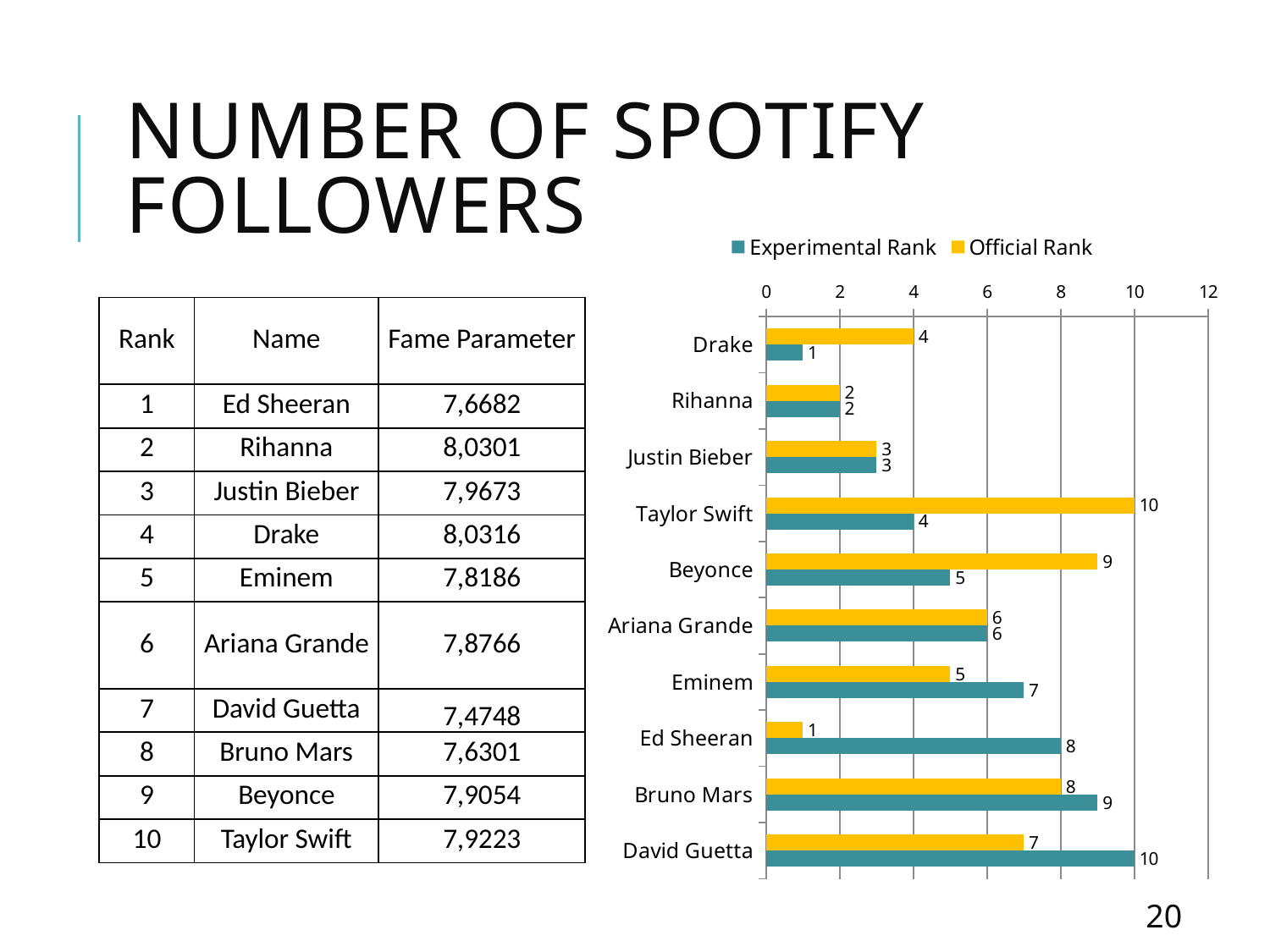
Which artist has the highest Experimental Rank value? David Guetta Which colour represents the Official Rank series in the chart? yellow What is the Experimental Rank value for Ed Sheeran? 8 For Eminem, which is larger: the Experimental Rank or the Official Rank? Experimental Rank How many artists are plotted on the chart? 10 What kind of chart is shown on the slide? bar chart What is the difference between the Experimental Rank and Official Rank values for Ed Sheeran? 7 What is the Official Rank value for Drake? 4 What is the Official Rank value for Taylor Swift? 10 What is the difference between the Official Rank and Experimental Rank values for Taylor Swift? 6 How many series does the chart legend list? 2 Which artist has the lowest Official Rank value? Ed Sheeran